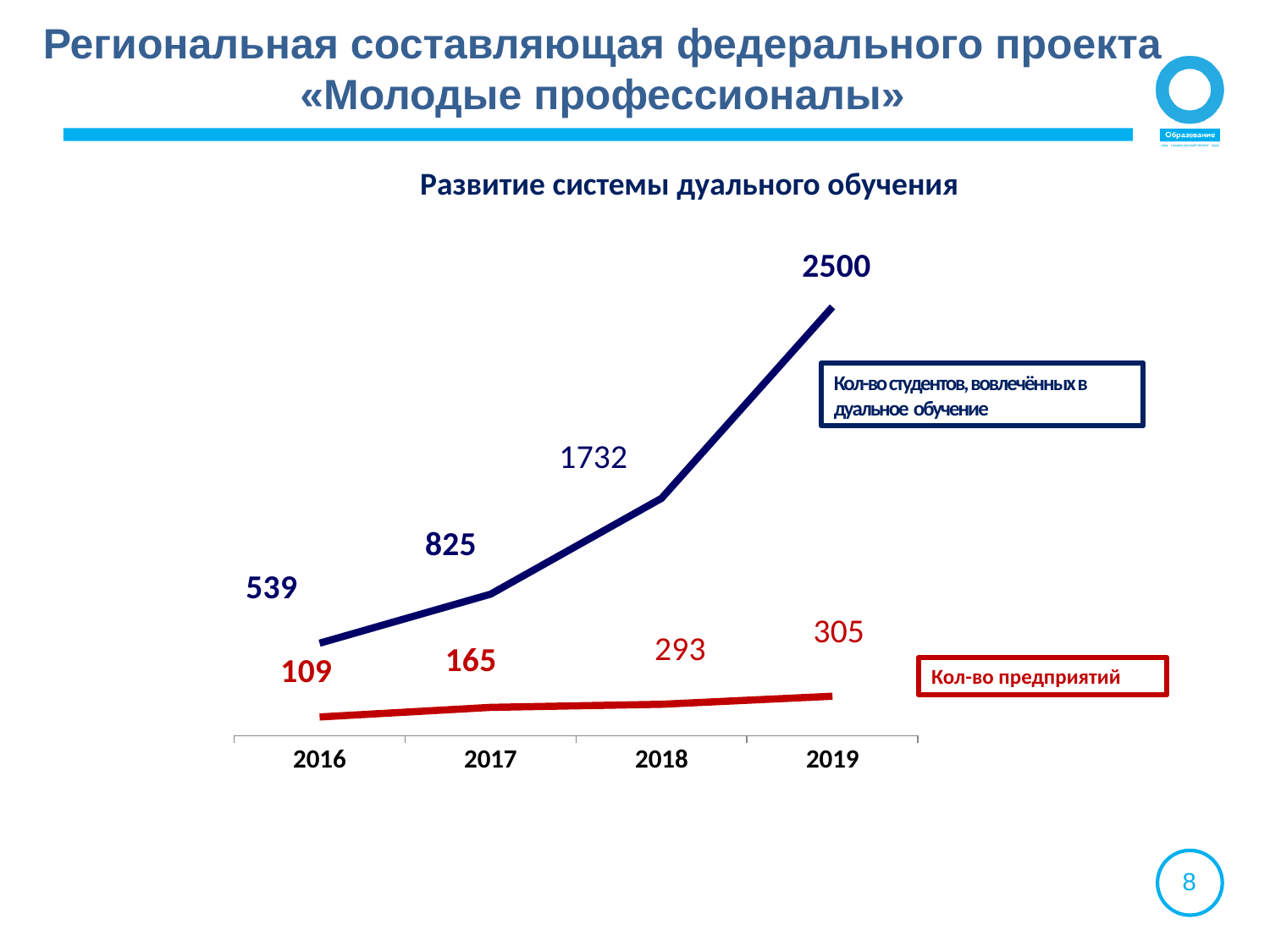
What is the number of students involved in dual education in 2018? 1732 Which is larger: the number of students in 2017 or the number of enterprises in 2019? the number of students in 2017 Does the number of students involved in dual education rise or fall from 2016 to 2019? rise In which year is the number of students involved in dual education highest? 2019 What is the number of enterprises (Кол-во предприятий) in 2017? 165 How many series are plotted on the chart? 2 What is the difference between the number of enterprises in 2018 and in 2017? 128 How many years are shown on the x axis? 4 What is the number of students involved in dual education in 2016? 539 What is the difference between the number of students in 2019 and in 2018? 768 In which year is the number of enterprises lowest? 2016 What type of chart is shown on the slide? line chart